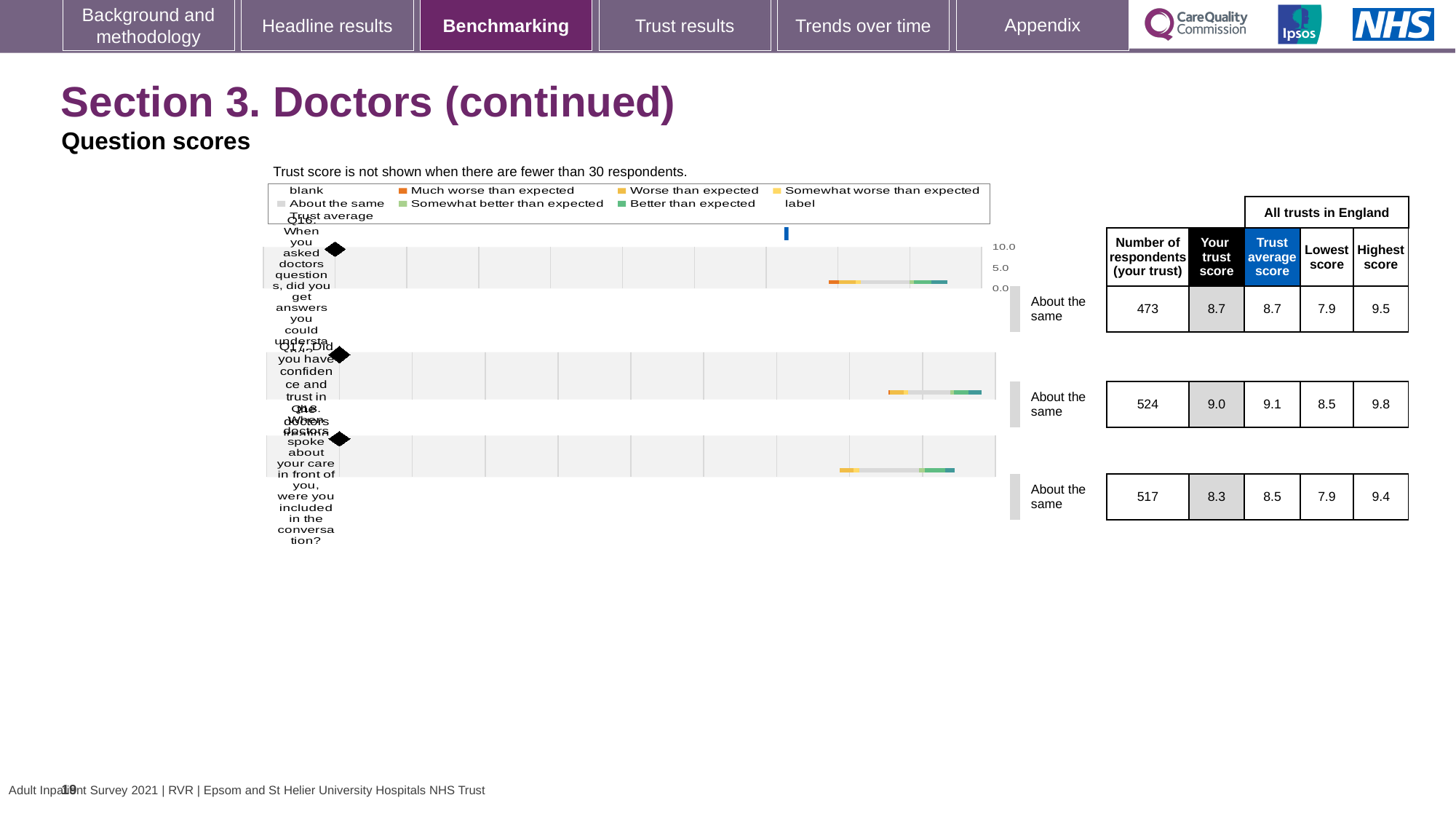
What benchmark category is shown for Q18? About the same Which question has the highest trust score? Q17 What is the trust score for Q18 (When doctors spoke about your care in front of you, were you included in the conversation)? 8.3 What is the maximum value shown on the chart's score axis? 10.0 What kind of chart is used to show the question scores on this slide? bar chart How many respondents answered Q17 at this trust? 524 What is the trust score for Q17 (Did you have confidence and trust in the doctors treating you)? 9.0 What is the difference between the highest score and the lowest score across all trusts in England for Q17? 1.3 How many questions (categories) are plotted in the question scores chart? 3 What is the trust score for Q16 (When you asked doctors questions, did you get answers you could understand)? 8.7 Which is larger, the trust score for Q16 or the trust score for Q18? Q16 Which question has the lowest trust score? Q18